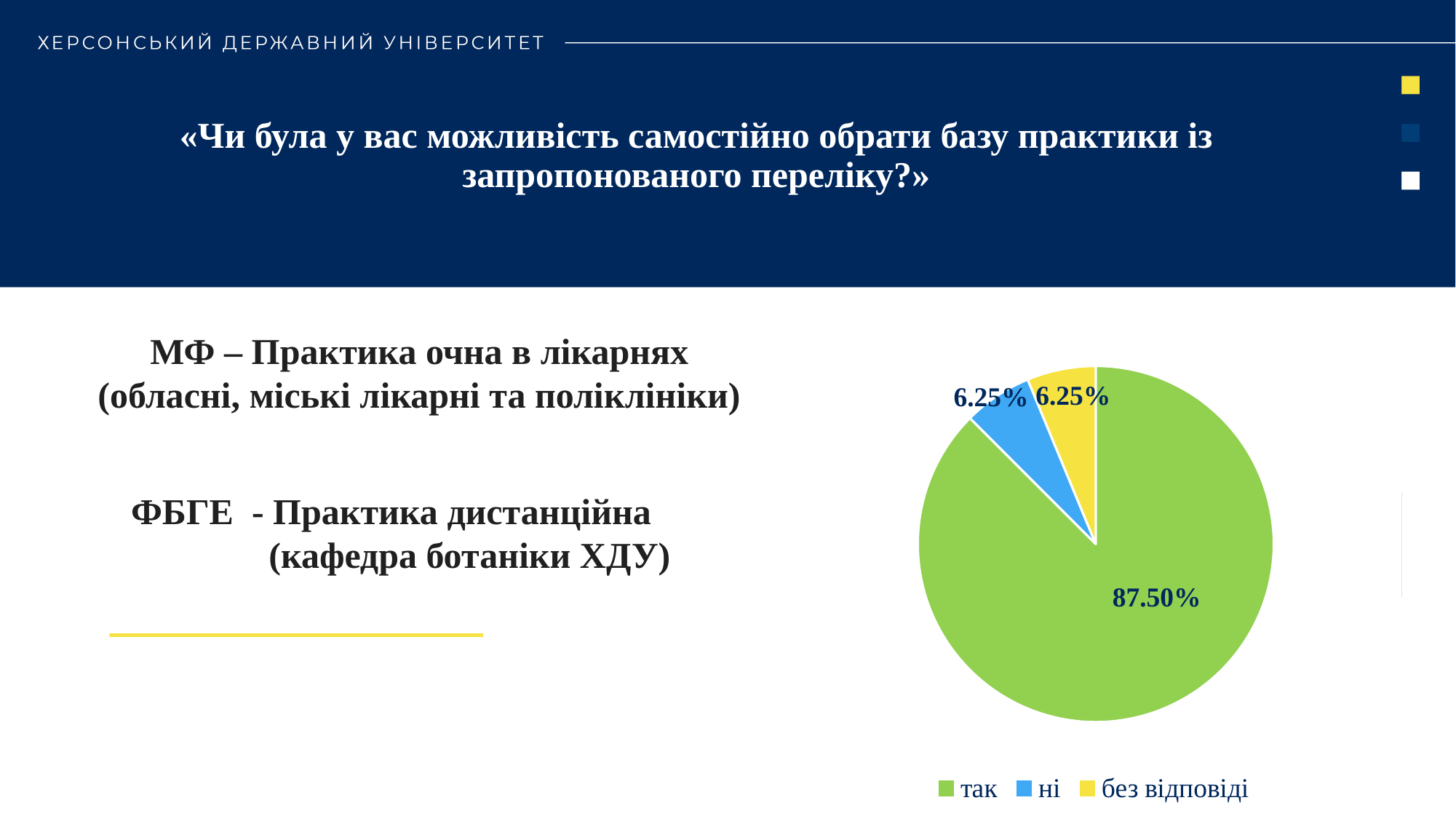
What is the value shown for "ні" in the pie chart? 6.25% What colour is the "так" slice in the pie chart? green What share of the pie does the "так" slice represent? 87.50% Which category has the largest slice of the pie chart? так How many entries does the legend of the pie chart list? 3 What colour is the "ні" slice in the pie chart? blue How many slices does the pie chart have? 3 What is the difference between the "так" slice and the "ні" slice? 81.25% What kind of chart is shown on the slide? pie chart What is the value shown for "без відповіді" in the pie chart? 6.25% Which is larger in the pie chart, "так" or "без відповіді"? так Is the value for "так" greater or less than 50%? greater